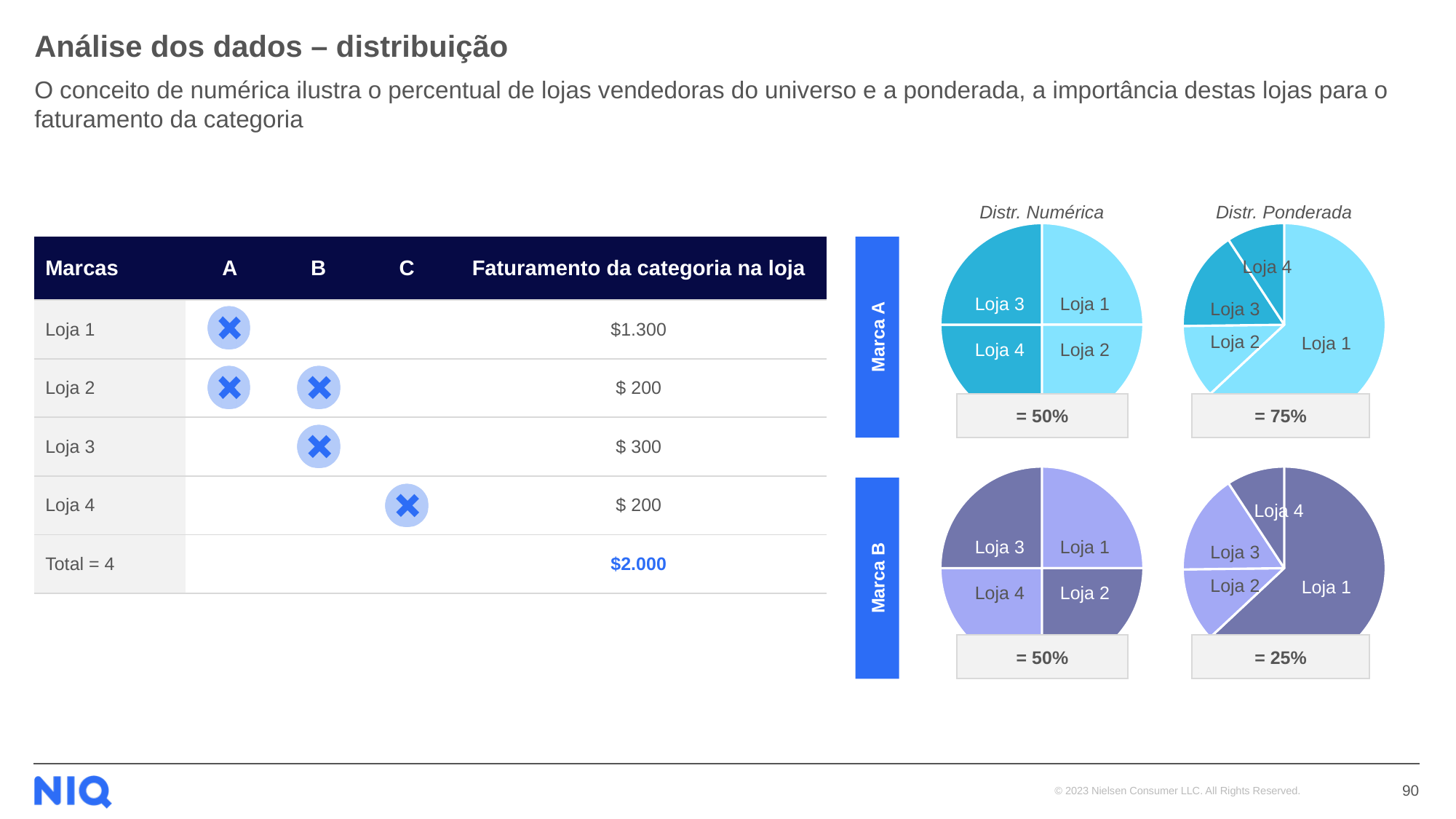
In the Marca B Distr. Ponderada pie chart, which slice is larger, Loja 1 or Loja 3? Loja 1 What percentage is shown below the Marca B Distr. Ponderada pie chart? = 25% What percentage is shown below the Marca A Distr. Ponderada pie chart? = 75% What are the two column headings above the pie charts? Distr. Numérica and Distr. Ponderada What percentage is shown below the Marca B Distr. Numérica pie chart? = 50% What is the difference between the percentage shown for Marca A Distr. Ponderada and Marca B Distr. Ponderada? 50% What kind of charts are shown on the right side of the slide? Pie charts In the Marca A Distr. Ponderada pie chart, which slice is the largest? Loja 1 How many slices does the Marca A Distr. Numérica pie chart have? 4 Which is larger, the percentage shown for Marca A Distr. Ponderada or for Marca B Distr. Ponderada? Marca A Distr. Ponderada What percentage is shown below the Marca A Distr. Numérica pie chart? = 50% How many pie charts are on the slide? 4